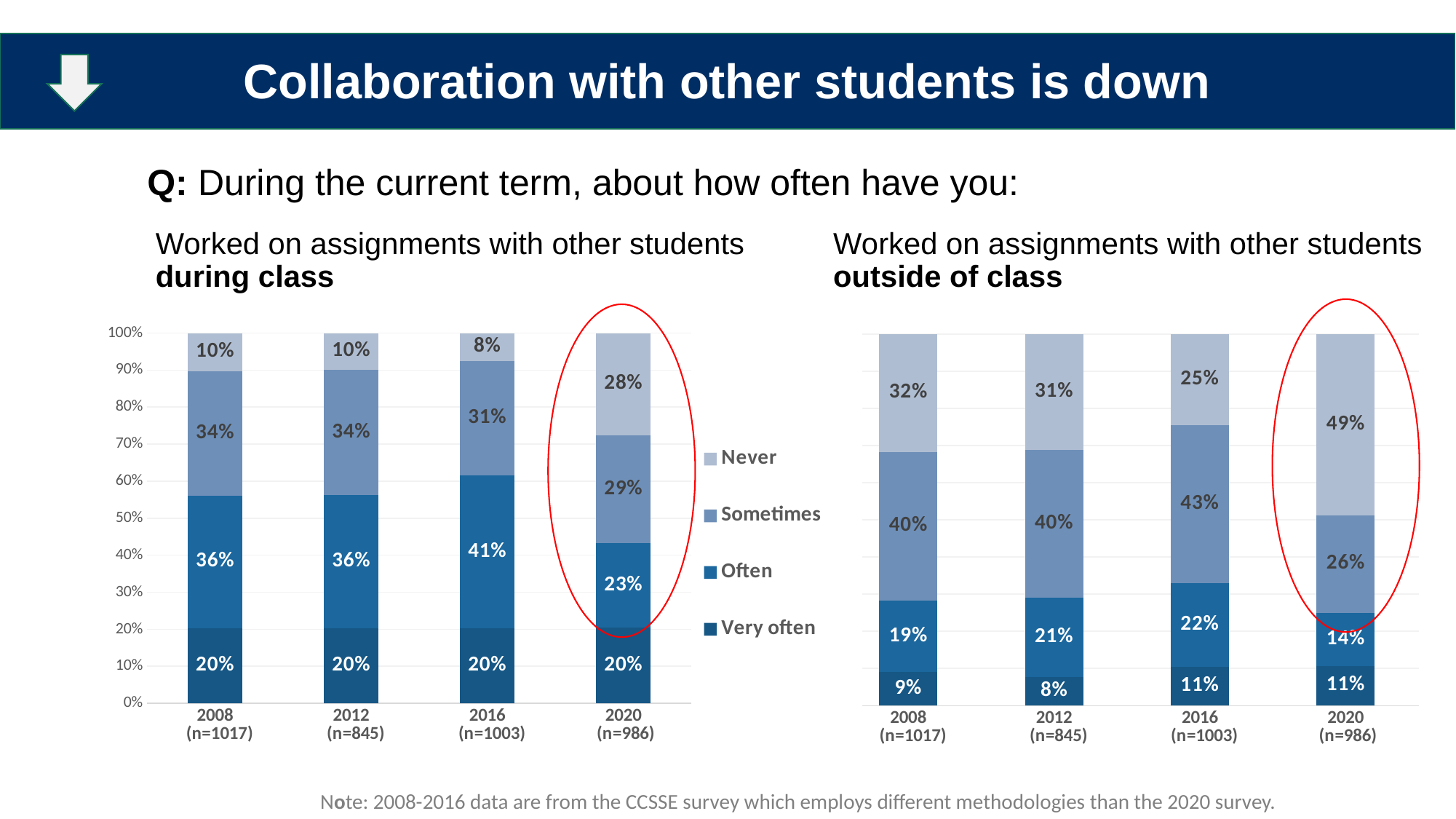
In the 'outside of class' chart on the right, what is the combined 'Often' and 'Very often' share for 2020? 25% In the 'during class' chart on the left, what is the 'Often' value for 2016? 41% What type of chart is the 'outside of class' chart on the right? Stacked bar chart In the 'outside of class' chart on the right, which year has the lowest 'Sometimes' value? 2020 How many series does the legend list for the charts on the slide? 4 In the 'during class' chart on the left, what is the 'Never' value for 2020? 28% In the 'outside of class' chart on the right, is the 'Never' value for 2020 larger or smaller than the 'Never' value for 2016? larger In the 'during class' chart on the left, which year has the highest 'Never' value? 2020 In the 'during class' chart on the left, what is the difference between the 'Often' values for 2016 and 2020? 18% In the 'outside of class' chart on the right, what is the 'Never' value for 2020? 49% How many years are shown on the x axis of the 'during class' chart on the left? 4 In the 'outside of class' chart on the right, what is the 'Very often' value for 2012? 8%